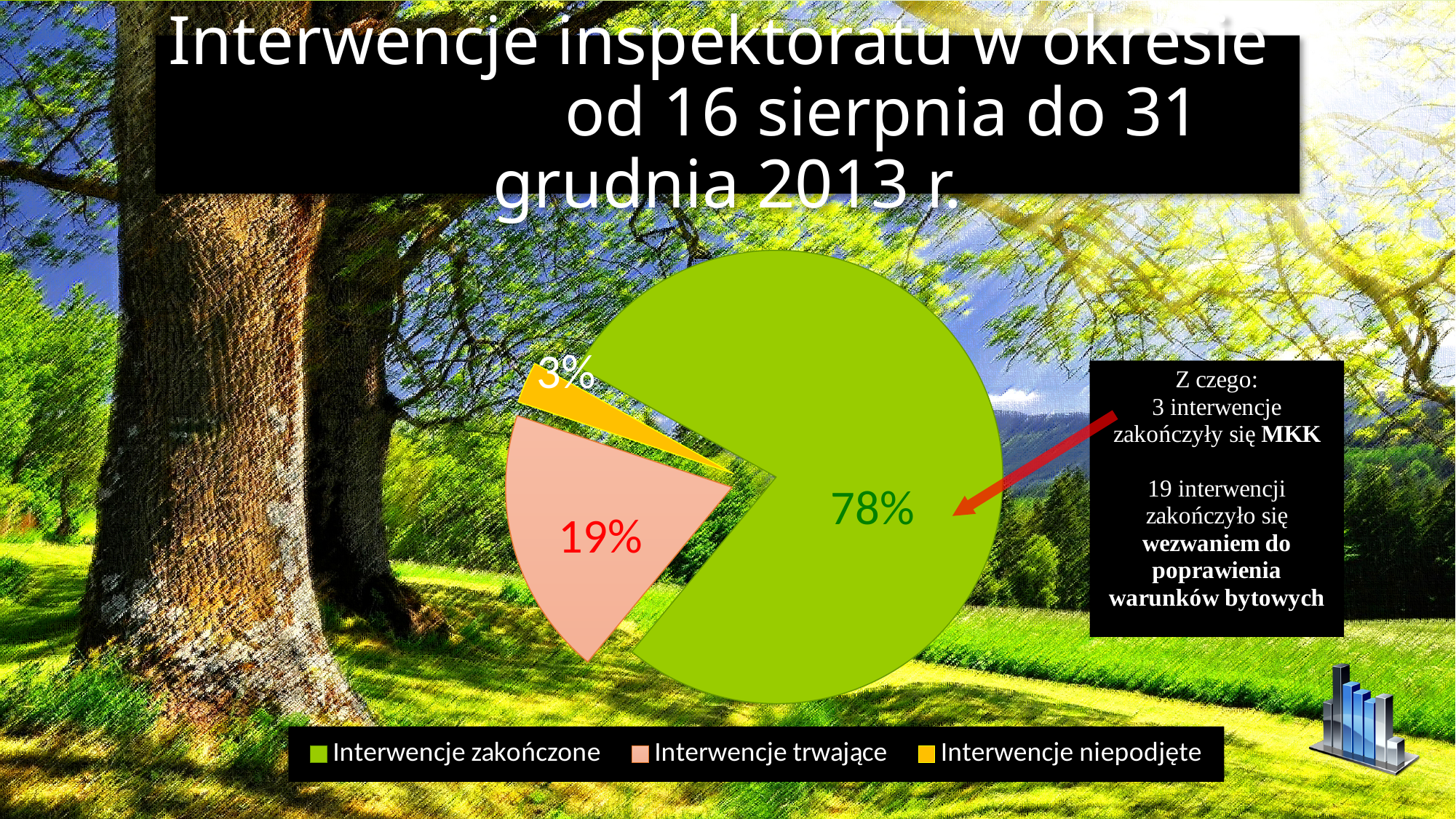
Which category has the largest slice of the pie? Interwencje zakończone What is the difference in percentage points between 'Interwencje trwające' and 'Interwencje niepodjęte'? 16 How many categories does the pie chart have? 3 What colour is the slice for 'Interwencje niepodjęte'? yellow What kind of chart is shown on the slide? pie chart What share of the pie is 'Interwencje trwające'? 19% What is the difference in percentage points between 'Interwencje zakończone' and 'Interwencje trwające'? 59 How many entries does the legend list? 3 What share of the pie is 'Interwencje zakończone'? 78% Which is larger, the slice for 'Interwencje trwające' or the slice for 'Interwencje niepodjęte'? Interwencje trwające Which category has the smallest slice of the pie? Interwencje niepodjęte What share of the pie is 'Interwencje niepodjęte'? 3%